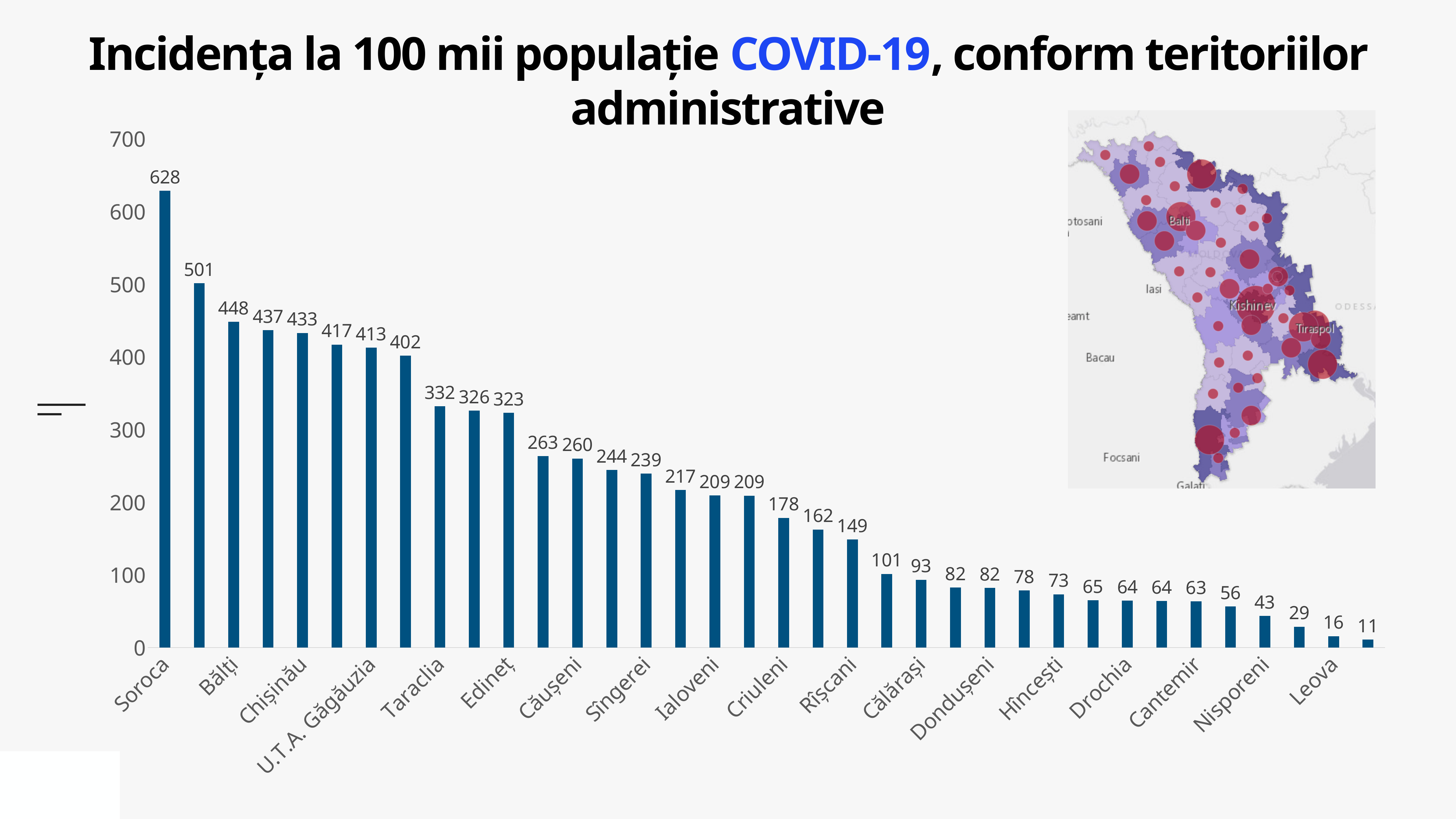
Which is larger, the value for Soroca or the value for Bălți? Soroca Which territory has the highest incidence in the chart? Soroca What type of chart is shown on the slide? bar chart Is the value for Soroca greater or less than 600? greater What is the difference between the highest value (628) and the lowest value (11) in the chart? 617 What is the incidence value for Bălți? 448 What is the highest value shown in the chart? 628 How many bars are plotted in the chart? 36 What is the incidence value for Leova? 16 What is the incidence value for Soroca? 628 Do the values rise or fall from left to right along the x axis? fall What is the lowest value shown in the chart? 11